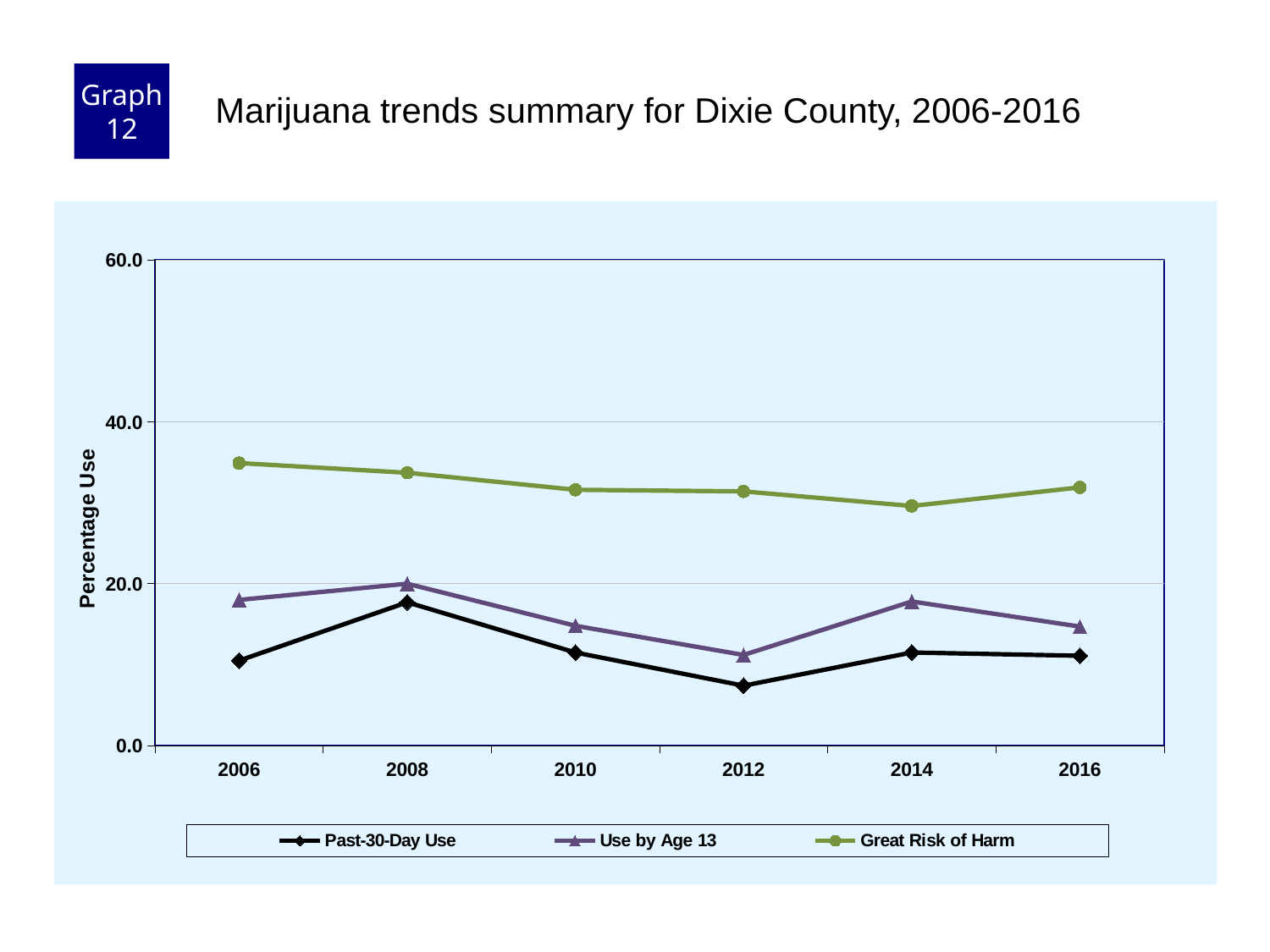
How many years are plotted along the x axis? 6 What is the label on the y axis? Percentage Use Is the value for Past-30-Day Use in 2012 greater or less than 20.0? less In which year is the Past-30-Day Use value lowest? 2012 Does the Great Risk of Harm line rise or fall from 2006 to 2014? fall Which is larger in 2010, Great Risk of Harm or Past-30-Day Use? Great Risk of Harm In which year is the Great Risk of Harm value lowest? 2014 What kind of chart is shown on the slide? line chart Which series has the highest values across all years? Great Risk of Harm In which year is the Past-30-Day Use value highest? 2008 How many series does the legend list? 3 Is the value for Great Risk of Harm in 2006 greater or less than 40.0? less